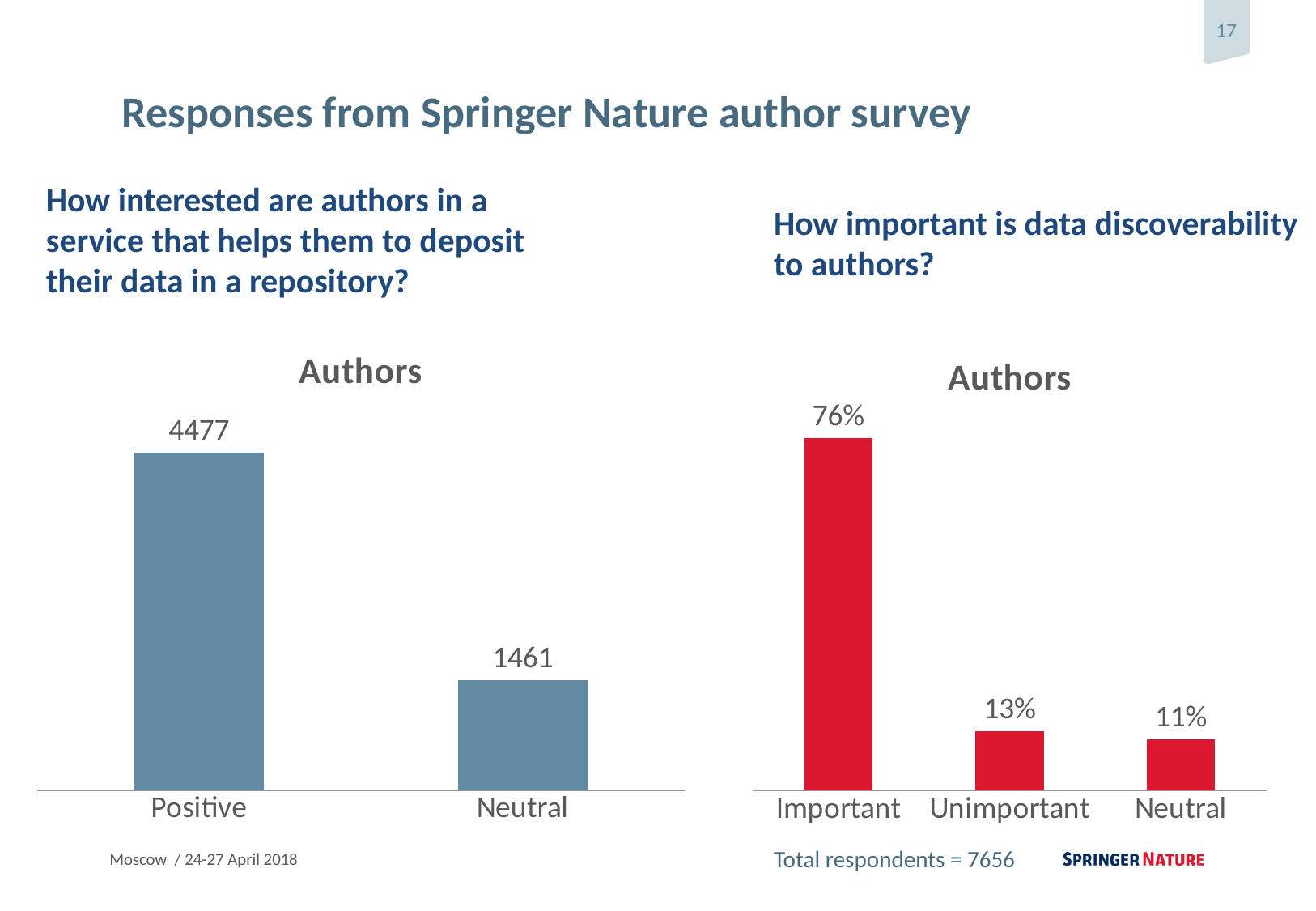
In the right chart (importance of data discoverability), what is the value for Unimportant? 13% In the left chart (interest in a data deposit service), which category has the higher value? Positive In the left chart (interest in a data deposit service), how many categories are shown? 2 What type of chart is the right chart (importance of data discoverability)? Bar chart In the left chart (interest in a data deposit service), what is the value for Neutral? 1461 In the right chart (importance of data discoverability), how many categories are shown? 3 In the right chart (importance of data discoverability), which category has the lowest value? Neutral In the right chart (importance of data discoverability), what is the value for Important? 76% In the right chart (importance of data discoverability), what is the value for Neutral? 11% In the right chart (importance of data discoverability), what is the difference between the Important and Unimportant values? 63% In the left chart (interest in a data deposit service), what is the difference between the Positive and Neutral values? 3016 In the left chart (interest in a data deposit service), what is the value for Positive? 4477